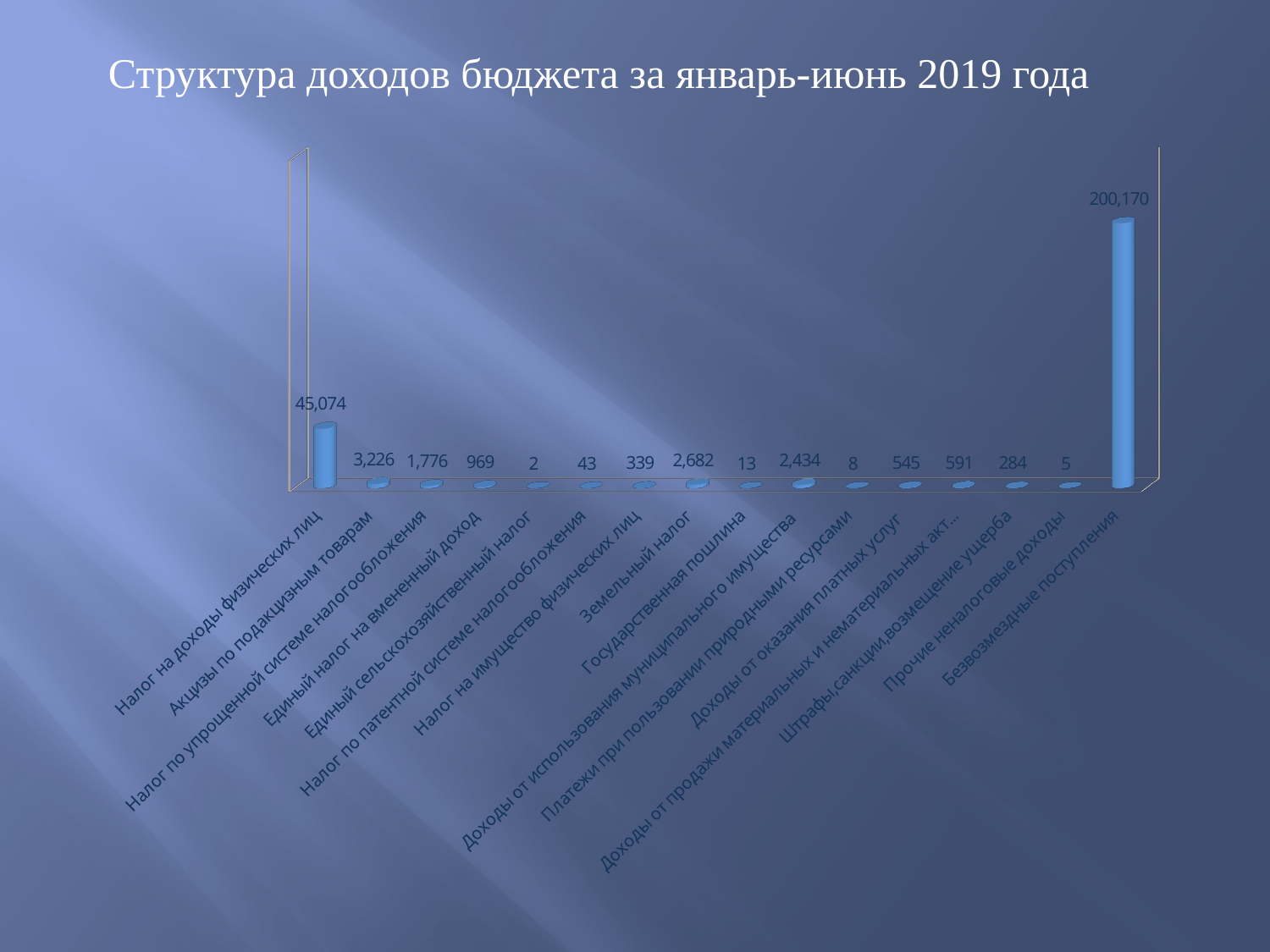
What is the value for Безвозмездные поступления? 200,170 Which is larger, Земельный налог or Доходы от использования муниципального имущества? Земельный налог Which category has the highest value? Безвозмездные поступления How many categories are shown in the chart? 16 What is the difference between Безвозмездные поступления and Налог на доходы физических лиц? 155,096 Which category has the lowest value? Единый сельскохозяйственный налог What is the difference between Акцизы по подакцизным товарам and Налог по упрощенной системе налогообложения? 1,450 What is the value for Налог на доходы физических лиц? 45,074 What is the value for Земельный налог? 2,682 What kind of chart is shown on the slide? Bar chart What is the value for Штрафы,санкции,возмещение ущерба? 284 What is the title of the slide? Структура доходов бюджета за январь-июнь 2019 года